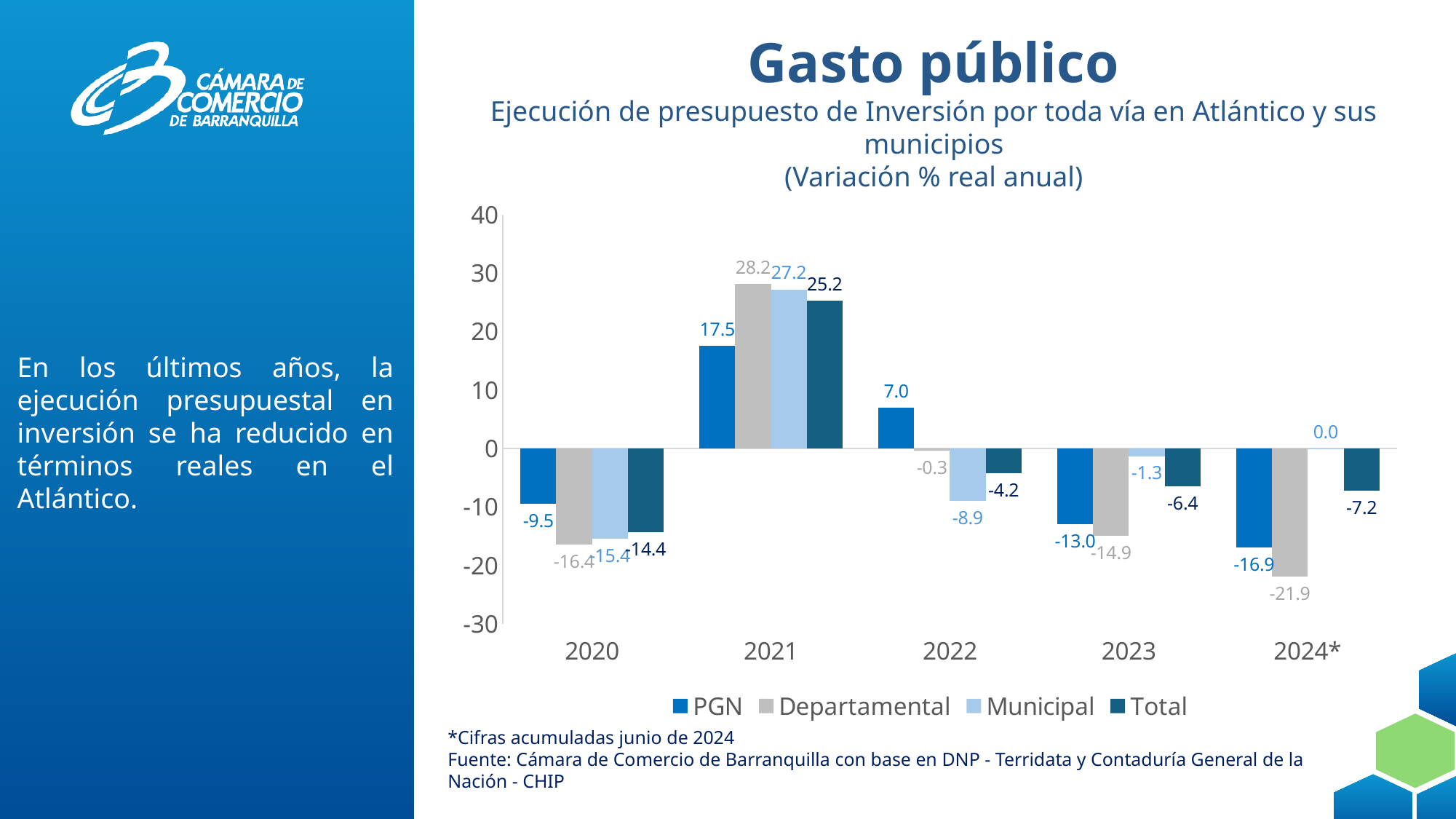
What is the value for Total in 2023? -6.4 Does the Total series rise or fall from 2021 to 2022? Fall How many years are shown on the x axis? 5 In which year is the Departamental series lowest? 2024* What kind of chart is shown on the slide? Bar chart In which year is the Total series highest? 2021 What is the value for Departamental in 2024*? -21.9 How many series does the legend list? 4 What is the value for Municipal in 2022? -8.9 What is the difference between the Departamental and PGN values in 2021? 10.7 What is the value for PGN in 2021? 17.5 Which is larger in 2023, the PGN value or the Municipal value? Municipal